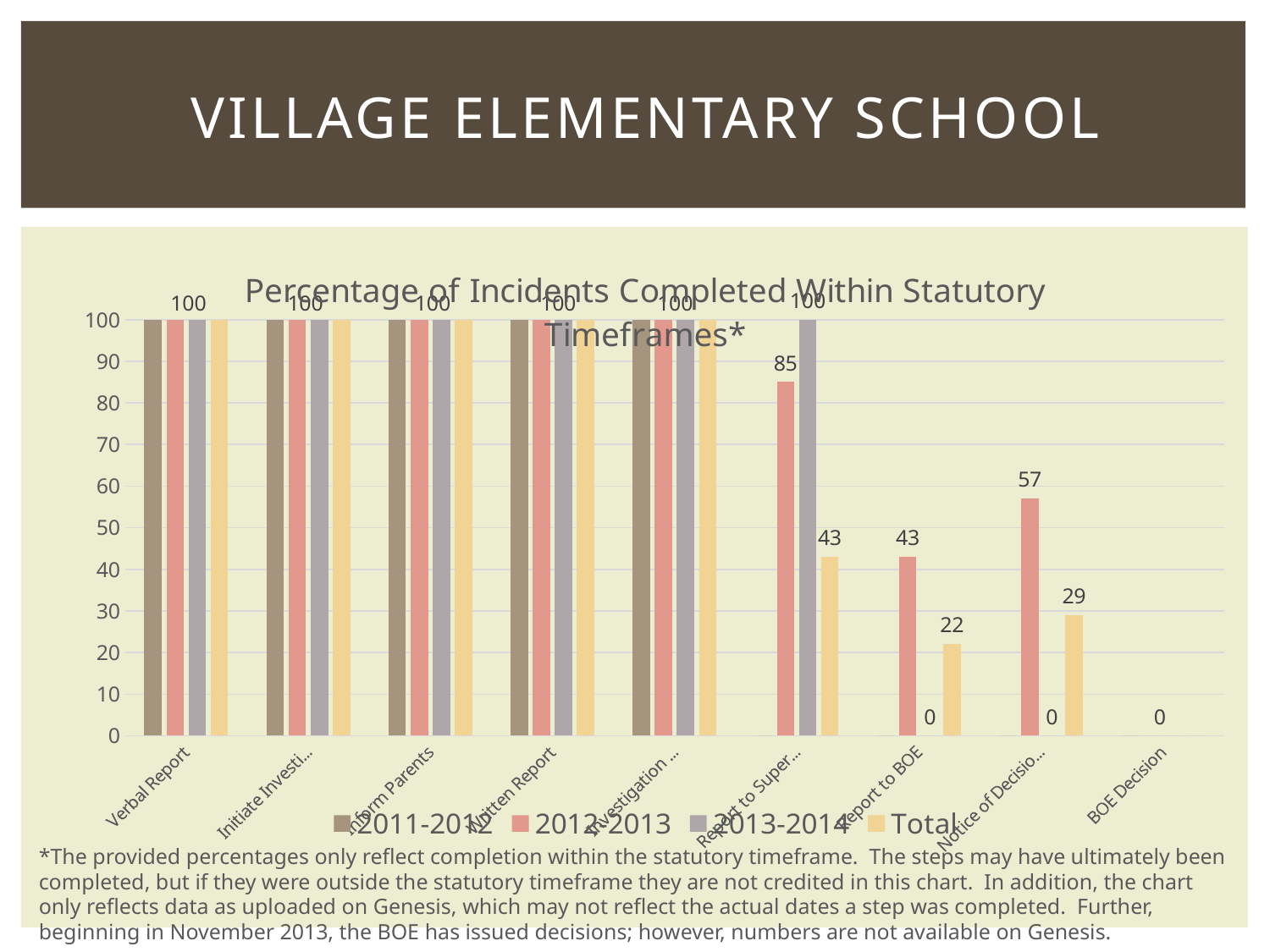
What kind of chart is shown on the slide? bar chart What is the Total value for Report to BOE? 22 What is the Total value for the category labelled 'Notice of Decisio…'? 29 What is the title of the chart? Percentage of Incidents Completed Within Statutory Timeframes* How many categories are shown along the x axis? 9 Which has the larger 2012-2013 value: Report to BOE or the category labelled 'Notice of Decisio…'? Notice of Decisio… What is the difference between the 2012-2013 value and the Total value for the category labelled 'Report to Super…'? 42 How many series does the legend list? 4 What is the 2012-2013 value for Report to BOE? 43 What is the 2012-2013 value for the category labelled 'Report to Super…'? 85 What is the value for 2011-2012 for Verbal Report? 100 What is the 2013-2014 value for Report to BOE? 0